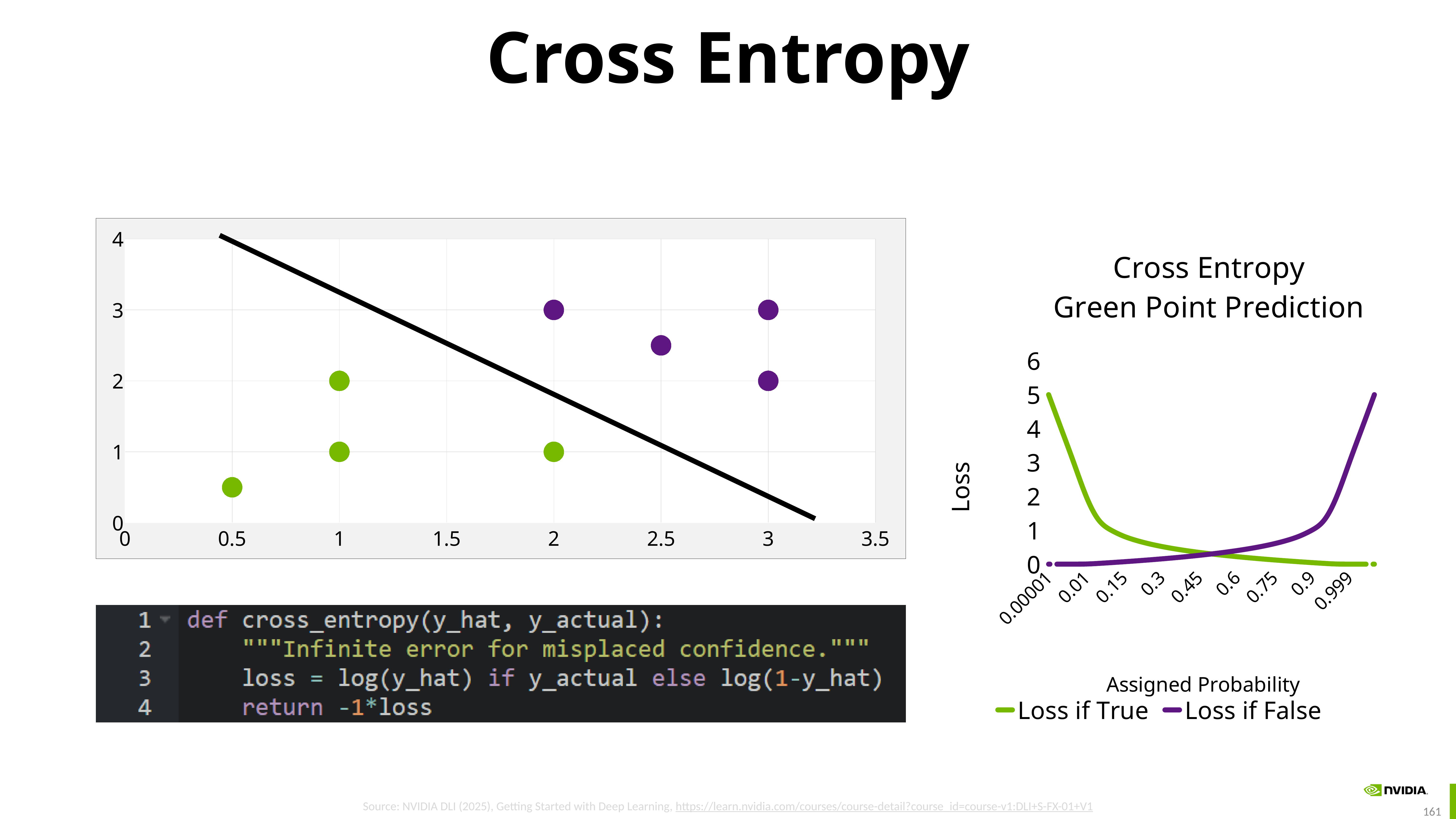
In the "Cross Entropy Green Point Prediction" chart, does the "Loss if False" line rise or fall as Assigned Probability increases? rise In the "Cross Entropy Green Point Prediction" chart, what is the label of the x axis? Assigned Probability What kind of chart is the chart on the left of the slide? scatter chart What kind of chart is the chart on the right titled "Cross Entropy Green Point Prediction"? line chart In the "Cross Entropy Green Point Prediction" chart, is the "Loss if False" value at 0.01 greater or less than 1? less In the "Cross Entropy Green Point Prediction" chart, what are the two legend entries? Loss if True, Loss if False In the "Cross Entropy Green Point Prediction" chart, does the "Loss if True" line rise or fall as Assigned Probability increases? fall In the scatter chart on the left, how many green points are plotted? 4 In the "Cross Entropy Green Point Prediction" chart, is the "Loss if True" value at 0.00001 greater or less than 4? greater In the "Cross Entropy Green Point Prediction" chart, how many series does the legend list? 2 In the "Cross Entropy Green Point Prediction" chart, which series has the larger value at 0.999, "Loss if True" or "Loss if False"? Loss if False In the scatter chart on the left, how many purple points are plotted? 4